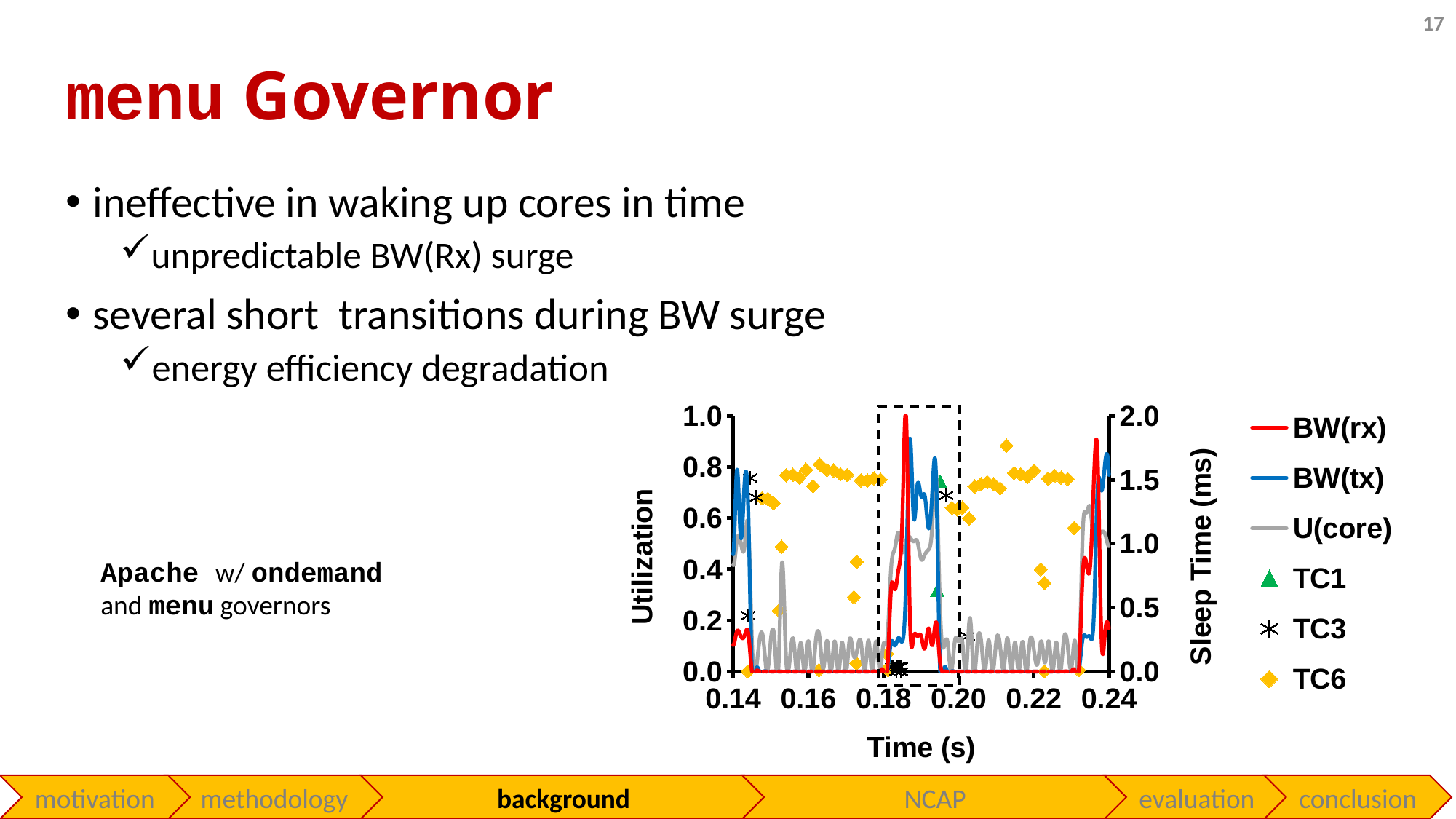
Is the U(core) utilization at 0.16 s greater or less than 0.4? less Is the BW(rx) utilization at 0.16 s greater or less than 0.2? less At the peak around 0.185 s, which is higher, BW(rx) or U(core)? BW(rx) How many series does the chart legend list? 6 Which line series reaches the highest utilization on the chart? BW(rx) What is the title of the x axis of the chart? Time (s) What is the label of the right-hand y axis of the chart? Sleep Time (ms) Does BW(rx) rise or fall between 0.18 s and 0.185 s? rise What kind of chart is shown on the slide? line chart Is the peak utilization of BW(rx) greater or less than 0.8? greater